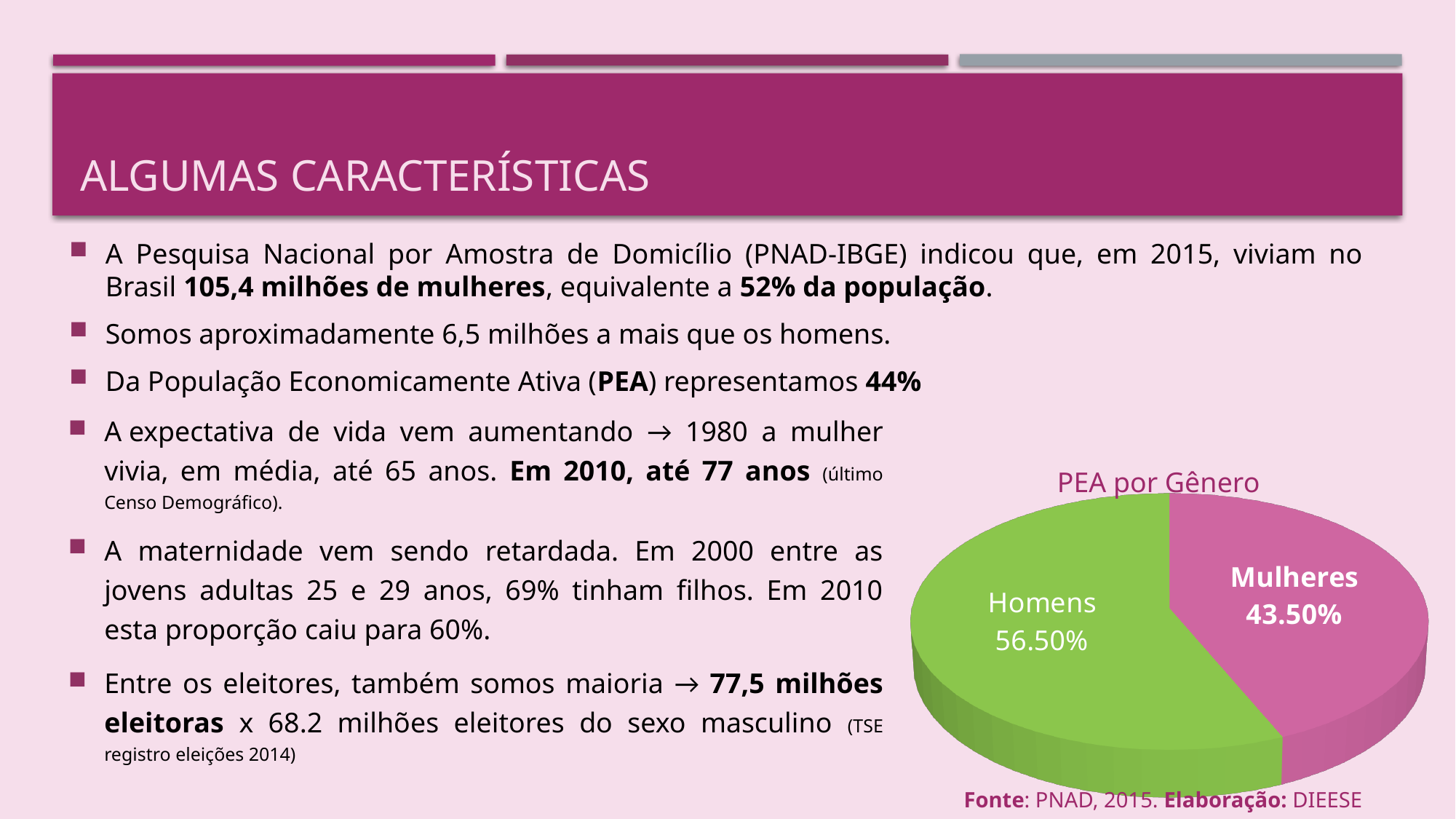
What is the title of the pie chart? PEA por Gênero What colour is the Mulheres slice in the pie chart? pink Which category has the smallest slice in the pie chart? Mulheres How many slices does the pie chart have? 2 Is the value for Mulheres greater or less than 50%? less Which category has the largest slice in the pie chart? Homens What share of the pie chart does Mulheres represent? 43.50% What share of the pie chart does Homens represent? 56.50% Which slice is larger, Homens or Mulheres? Homens Is the value for Homens greater or less than 50%? greater What is the difference in percentage points between the Homens and Mulheres slices? 13 percentage points What type of chart is shown on the slide? pie chart